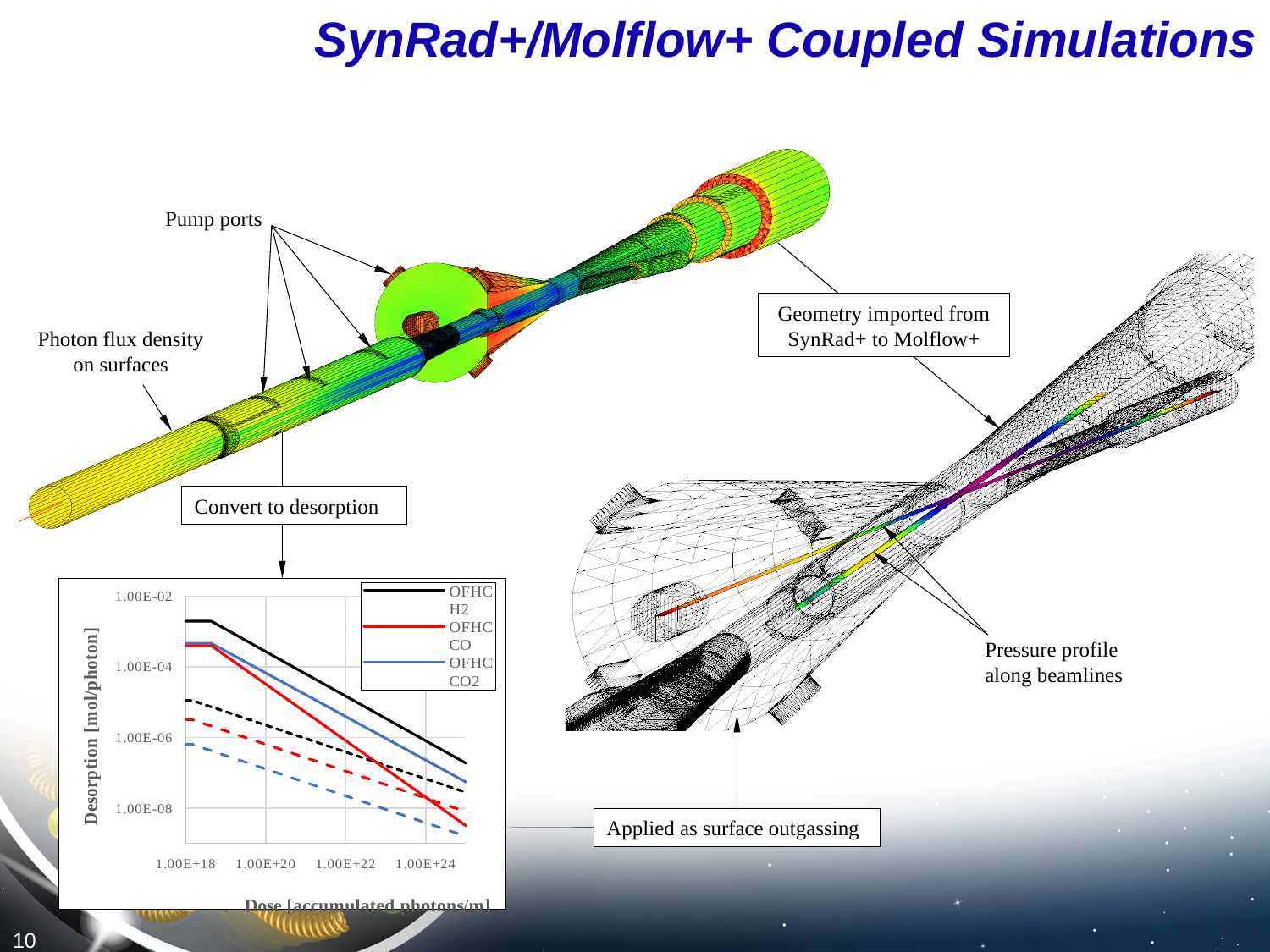
In the desorption chart, which legend series has the lowest desorption at the right end of the x axis (around 1.00E+24)? OFHC CO In the desorption chart, is the desorption for OFHC H2 at a dose of 1.00E+24 greater or less than 1.00E-08? greater How many tick labels are shown on the x axis of the desorption chart? 4 In the desorption chart, is the desorption for OFHC H2 at a dose of 1.00E+18 greater or less than 1.00E-04? greater In the desorption chart, does desorption rise or fall as dose increases along the x axis? fall In the desorption chart, which legend series has the highest desorption at a dose of 1.00E+18? OFHC H2 What kind of chart is shown at the bottom left of the slide? line chart In the desorption chart legend, what colour is the line for OFHC CO? red In the desorption chart, at a dose of 1.00E+18, which is larger: the desorption for OFHC H2 or for OFHC CO? OFHC H2 What is the y-axis label of the desorption chart? Desorption [mol/photon] How many series does the legend of the desorption chart list? 3 In the desorption chart, is the desorption for OFHC CO2 at a dose of 1.00E+18 greater or less than 1.00E-06? greater